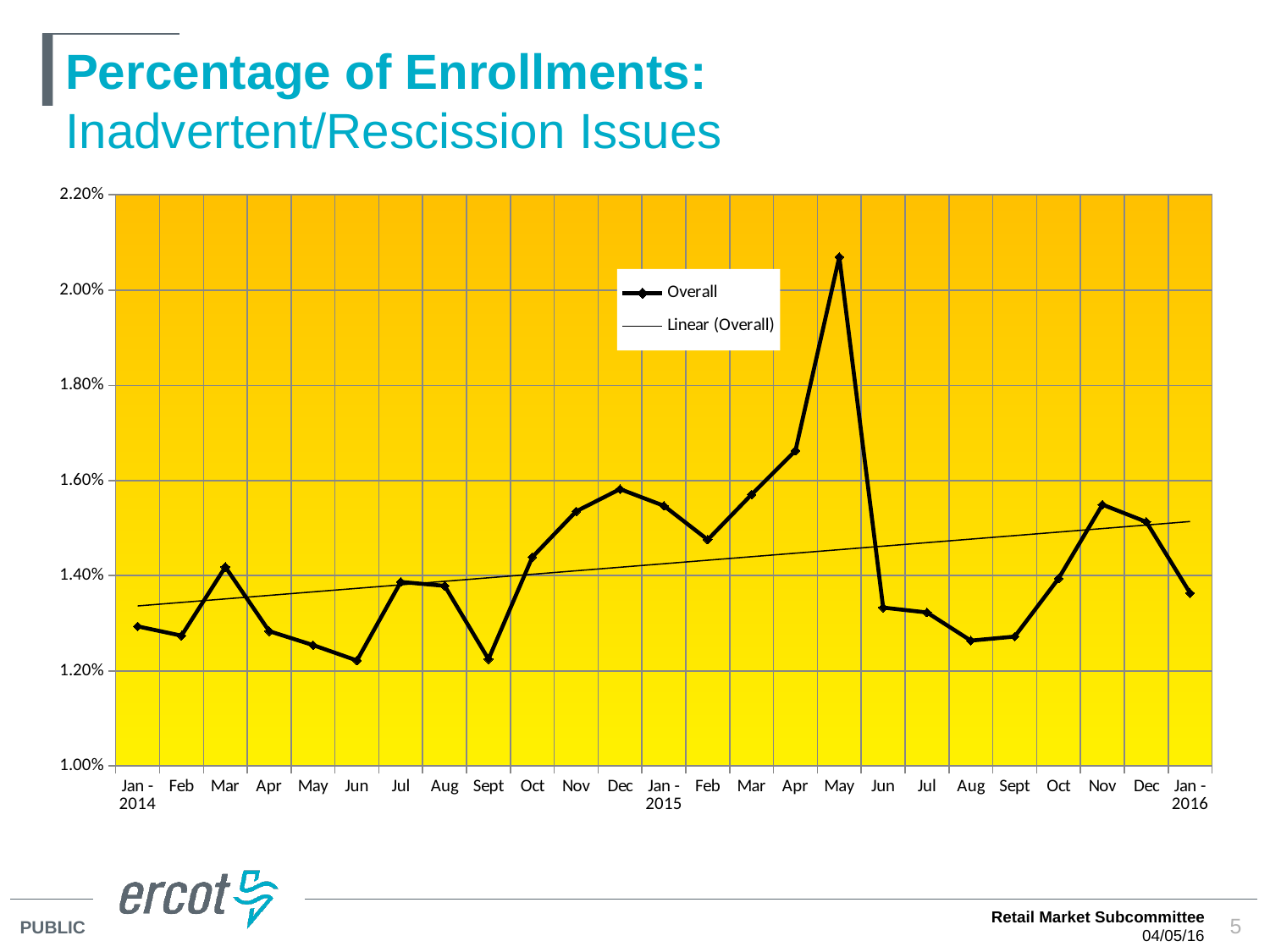
Is the Overall value for Aug 2015 greater or less than 1.40%? less Which is larger, the Overall value for Jul 2014 or for Jun 2014? Jul 2014 Is the Overall value for Jun 2014 greater or less than 1.40%? less What kind of chart is shown on the slide? line chart What are the two entries in the chart legend? Overall and Linear (Overall) In which month is the Overall percentage highest? May 2015 How many series does the legend list? 2 Is the Overall value for May 2015 greater or less than 2.00%? greater Which is larger, the Overall value for Nov 2015 or for Aug 2015? Nov 2015 How many monthly data points are plotted on the Overall line? 25 Does the Linear (Overall) trend line rise or fall from Jan 2014 to Jan 2016? rises